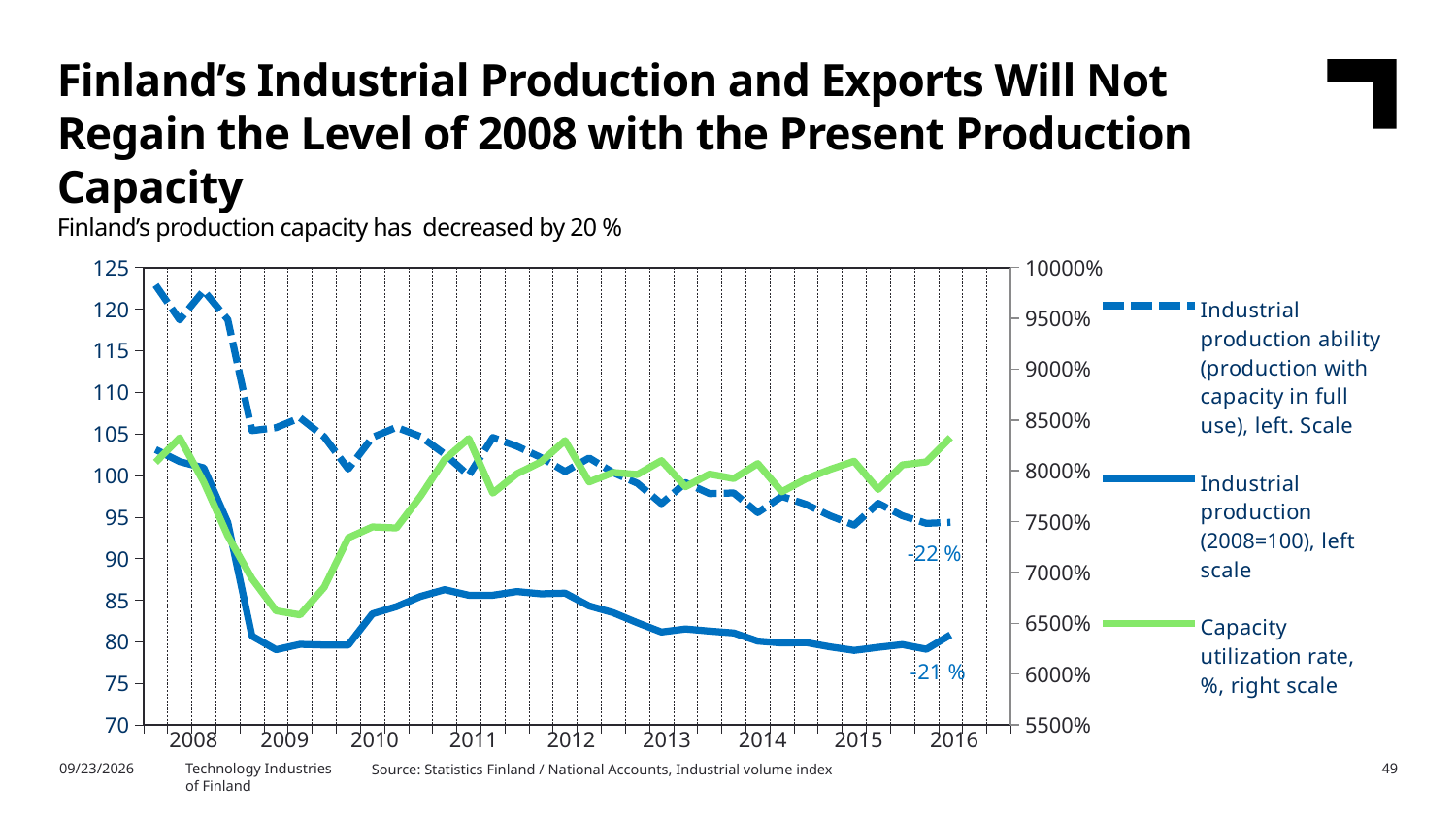
In 2009, which is higher on the left scale: 'Industrial production ability' or 'Industrial production (2008=100)'? Industrial production ability What percentage change is annotated next to the solid 'Industrial production (2008=100)' line at the right end of the chart? -21 % What is the highest value shown on the left axis? 125 What percentage change is annotated next to the dashed 'Industrial production ability' line at the right end of the chart? -22 % Is the value of 'Industrial production ability' at the start of 2008 greater or less than 120 on the left scale? greater Which series is plotted against the right scale? Capacity utilization rate, %, right scale Is the value of 'Industrial production (2008=100)' in 2009 greater or less than 85 on the left scale? less What kind of chart is shown on the slide? line chart Does the 'Industrial production ability' line rise or fall overall from 2008 to 2016? fall Is the value of 'Industrial production (2008=100)' in 2015 greater or less than 90 on the left scale? less How many series does the legend list? 3 How many year labels are shown on the x axis? 9